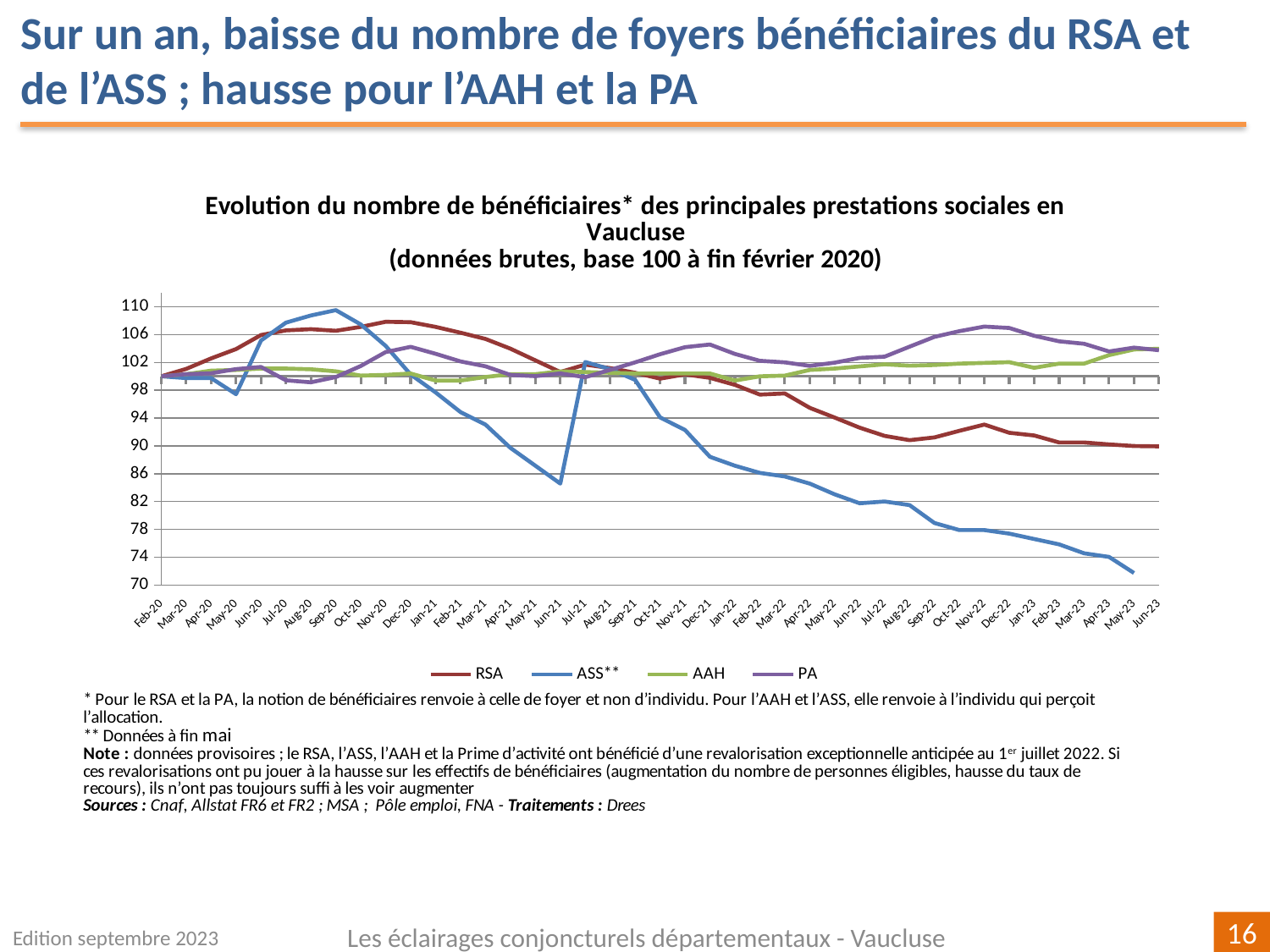
What kind of chart is shown on the slide? line chart Which series are listed in the legend? RSA, ASS**, AAH, PA Is the value for ASS** in Jun-21 greater or less than 86? less Is the value for RSA in Jun-23 greater or less than 94? less Is the value for ASS** in May-23 greater or less than 74? less In Dec-20, which is larger, the RSA value or the ASS** value? RSA Which series reaches the lowest value on the chart? ASS** How many series does the legend list? 4 What base value is used for the index according to the chart title? base 100 à fin février 2020 Does the ASS** series rise or fall between Jul-21 and May-23? fall